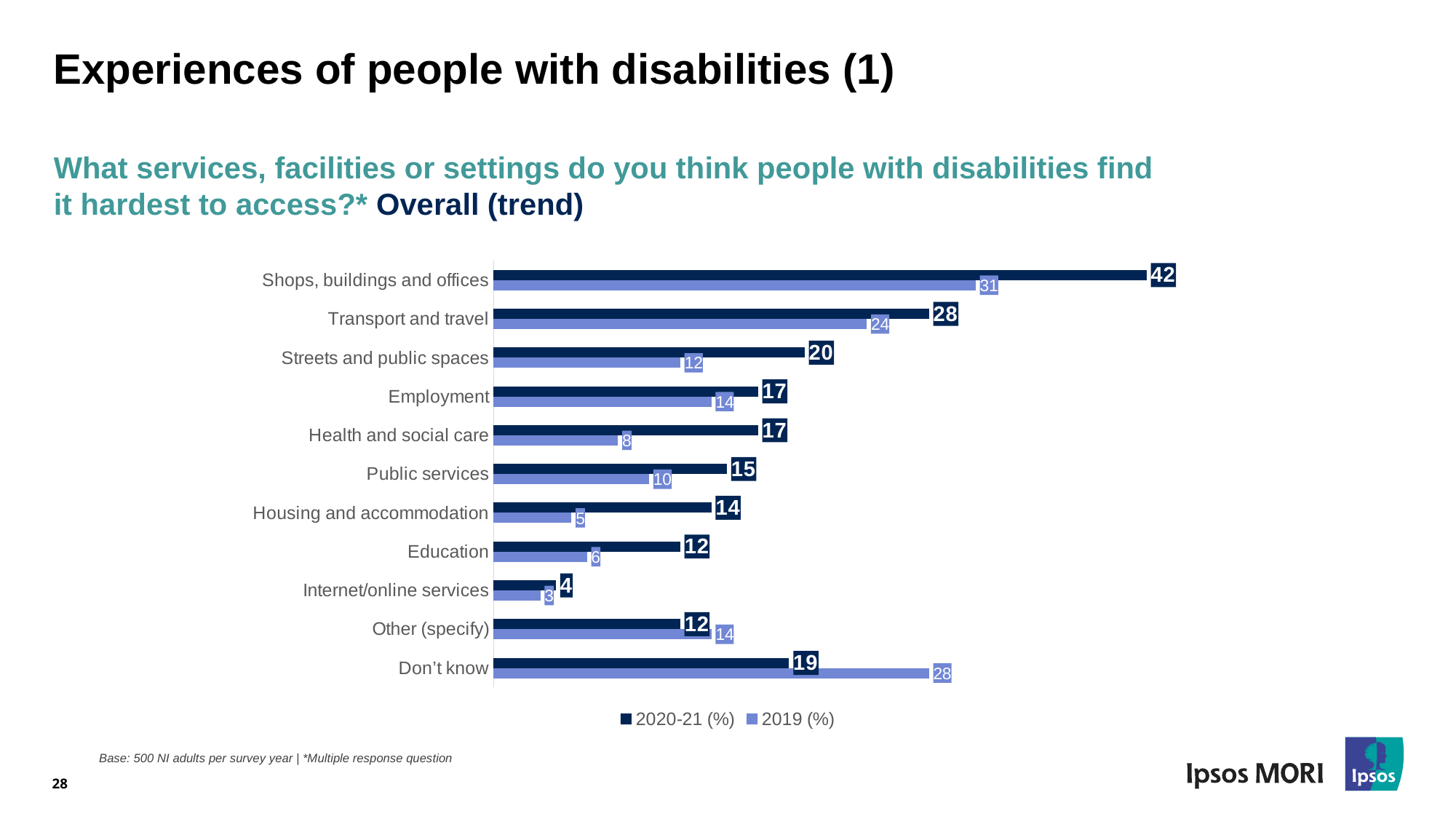
What kind of chart is shown on the slide? Bar chart Which category has the highest 2020-21 (%) value? Shops, buildings and offices Which is larger for Don't know: the 2020-21 (%) value or the 2019 (%) value? 2019 (%) What is the 2019 (%) value for Health and social care? 8 How many series does the legend list? 2 What are the two series named in the legend? 2020-21 (%) and 2019 (%) Which category has the lowest 2019 (%) value? Internet/online services What is the 2020-21 (%) value for Shops, buildings and offices? 42 What is the 2019 (%) value for Transport and travel? 24 What is the difference between the 2020-21 (%) and 2019 (%) values for Streets and public spaces? 8 How many categories are shown on the chart? 11 What is the 2020-21 (%) value for Don't know? 19